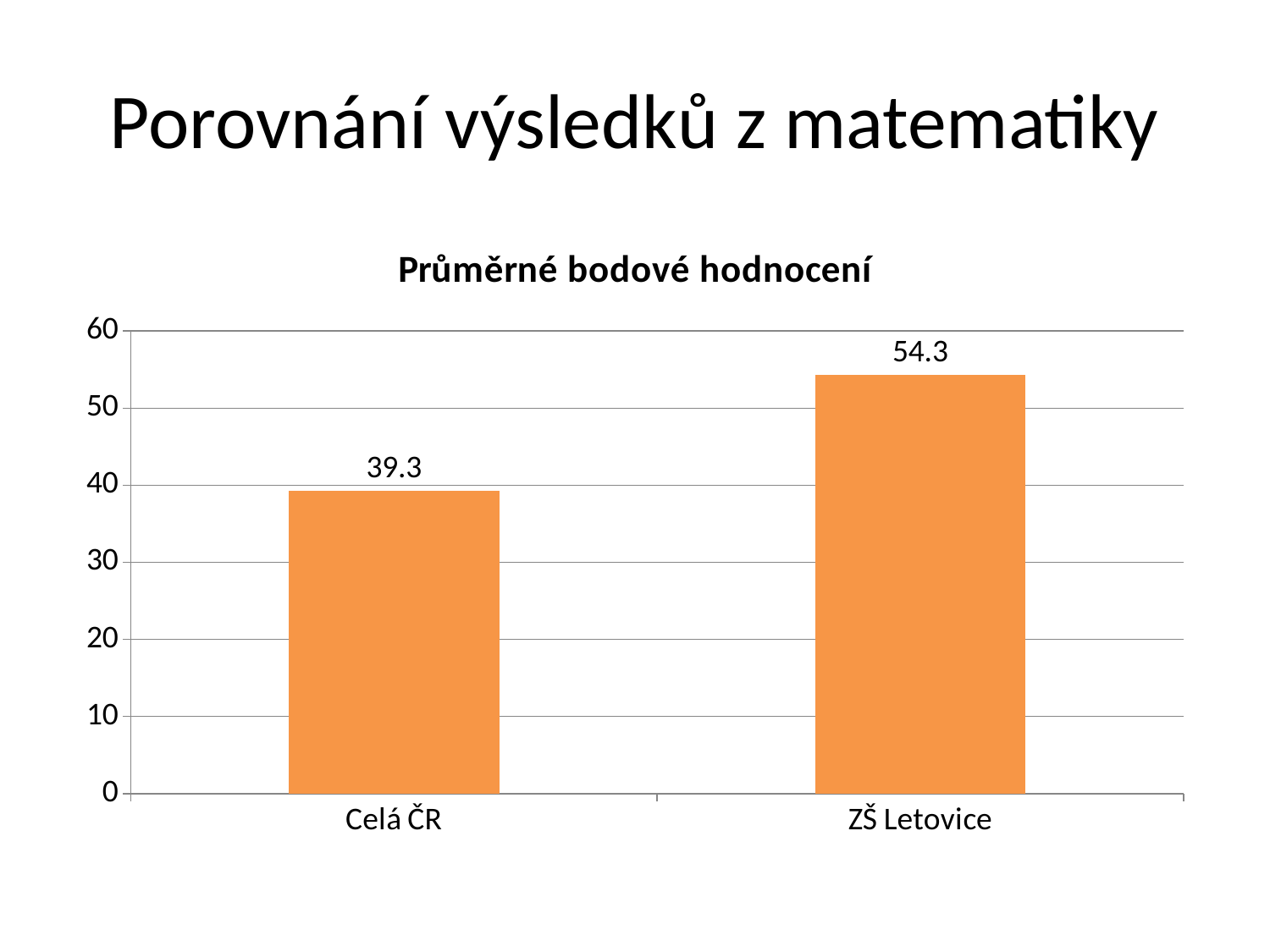
What kind of chart is shown on the slide? bar chart Is the value for Celá ČR greater or less than 40? less What is the value for Celá ČR? 39.3 How many categories are shown on the chart? 2 What is the title of the chart? Průměrné bodové hodnocení Which category has the lowest value? Celá ČR What is the highest value shown on the vertical axis? 60 Which category has the highest value? ZŠ Letovice Which is larger, the value for Celá ČR or the value for ZŠ Letovice? ZŠ Letovice Is the value for ZŠ Letovice greater or less than 50? greater What is the value for ZŠ Letovice? 54.3 What is the difference between the values for ZŠ Letovice and Celá ČR? 15